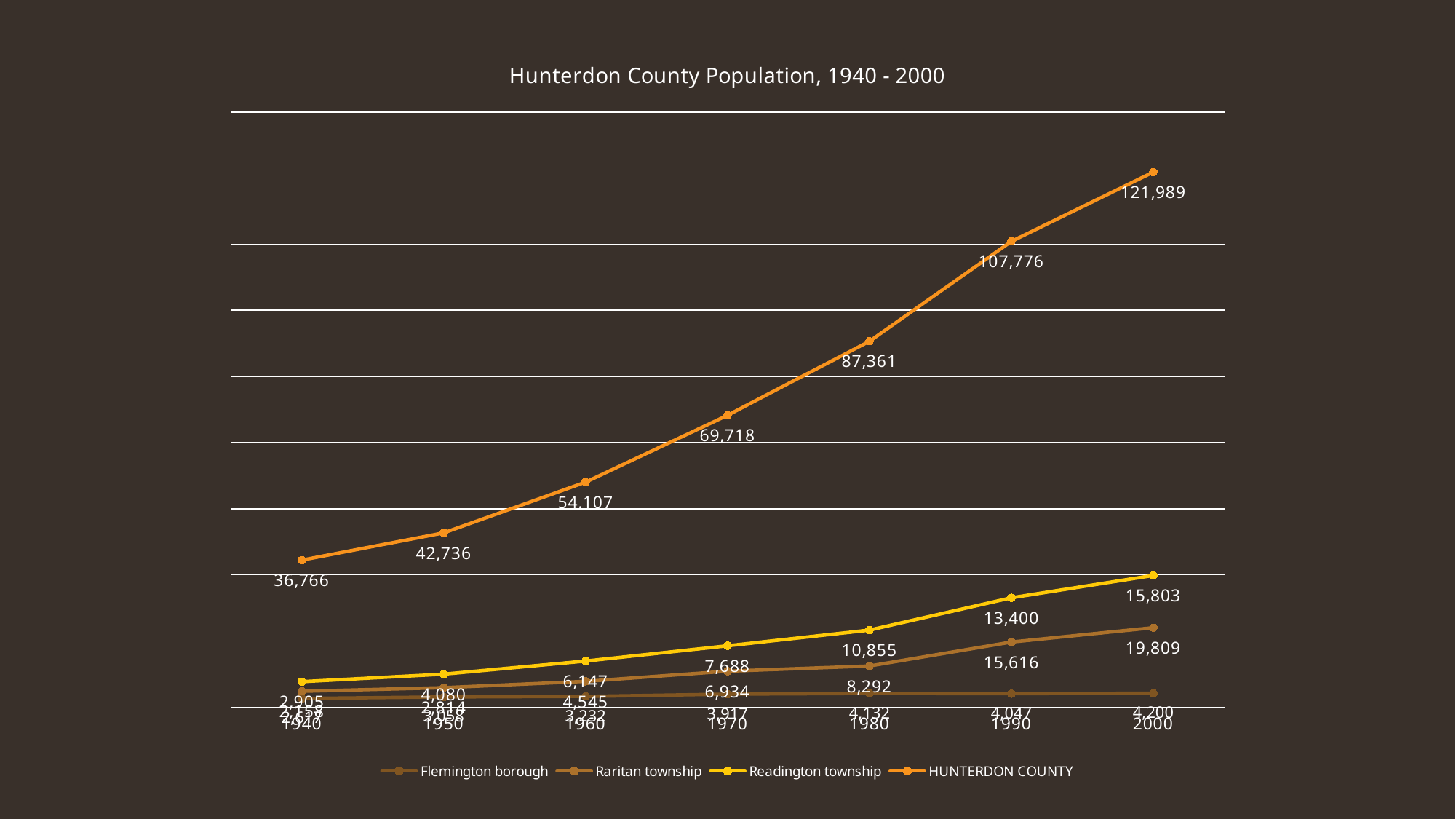
By how much did the HUNTERDON COUNTY population grow from 1940 to 2000? 85,223 What is the HUNTERDON COUNTY population in 1940? 36,766 What is the title of the chart? Hunterdon County Population, 1940 - 2000 How many series does the legend list? 4 In which year is the HUNTERDON COUNTY population highest? 2000 What is the Readington township population in 1980? 10,855 How many years are plotted along the x axis? 7 What is the HUNTERDON COUNTY population in 2000? 121,989 By how much did the HUNTERDON COUNTY population increase between 1990 and 2000? 14,213 Does the HUNTERDON COUNTY line rise or fall from 1940 to 2000? rise What kind of chart is shown on the slide? line chart What is the Flemington borough population in 1970? 3,917